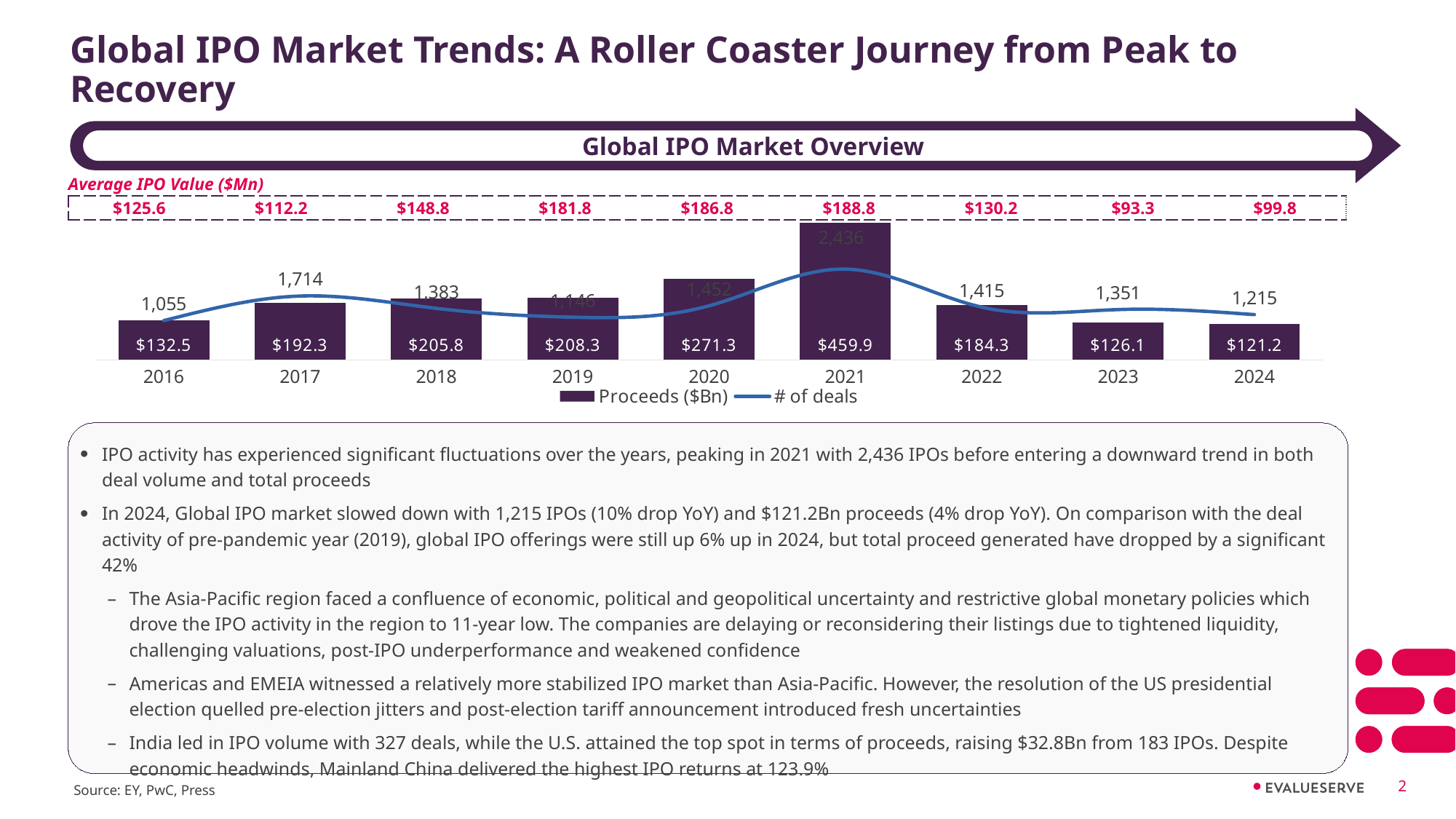
How many series does the chart legend list? 2 Which year has the lowest number of deals? 2016 Which year had more deals, 2018 or 2022? 2022 How many IPO deals does the line show for 2017? 1,714 What is the difference in proceeds ($Bn) between 2021 and 2020? $188.6 Which year has the lowest proceeds ($Bn)? 2024 What kind of chart is used to show proceeds ($Bn) and # of deals? Combined bar and line chart How many more deals were there in 2021 than in 2024? 1,221 What is the Average IPO Value ($Mn) shown above the chart for 2019? $181.8 Which year has the highest proceeds ($Bn)? 2021 What were the global IPO proceeds ($Bn) in 2021? $459.9 How many years are shown on the x axis of the chart? 9